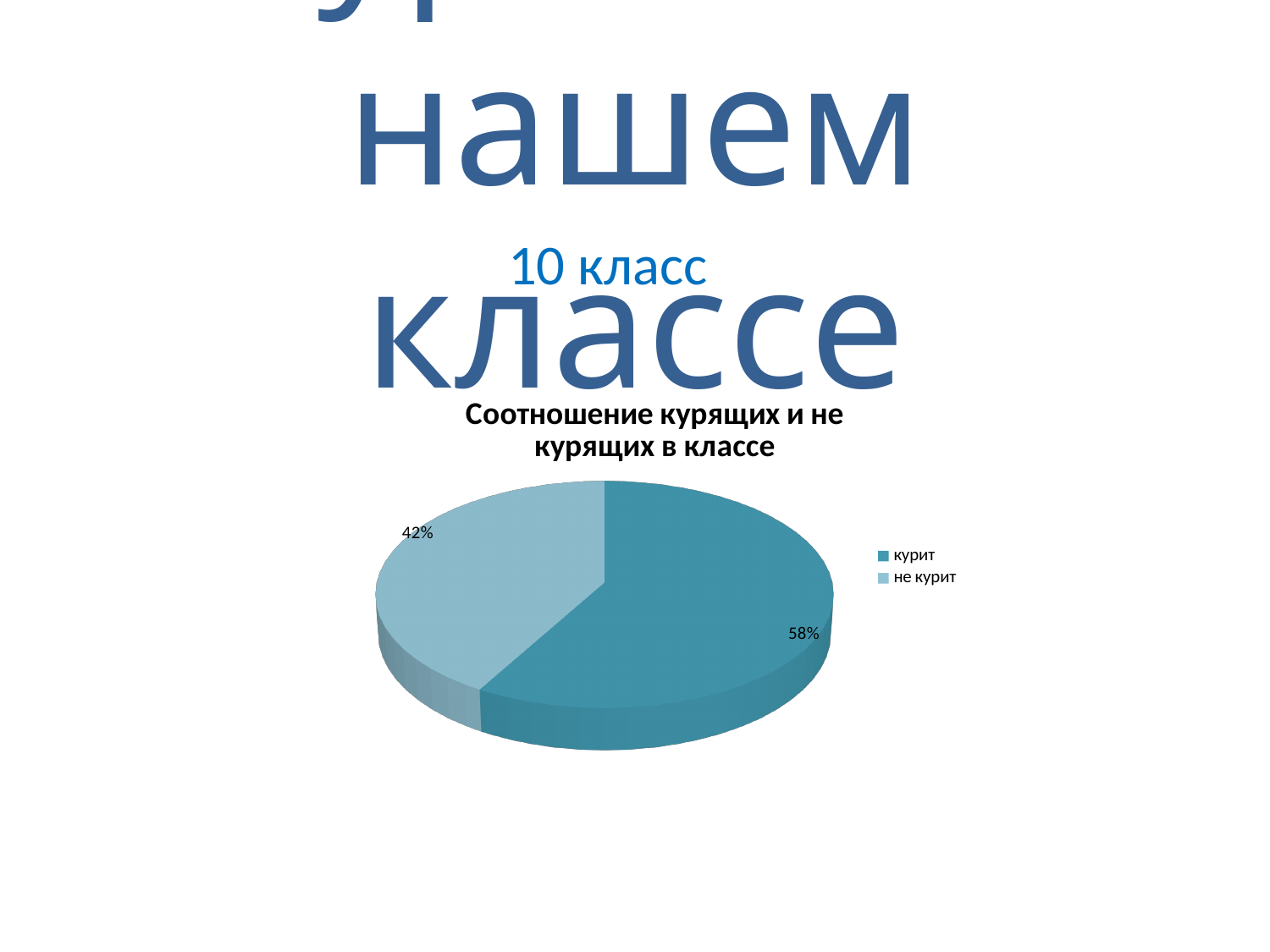
Which is larger, the 'курит' slice or the 'не курит' slice? курит How many entries does the legend list? 2 Which slice is the largest in the pie chart? курит What is the difference between the 'курит' and 'не курит' shares? 16% Which slice is the smallest in the pie chart? не курит Which legend entry is shown in the lighter blue colour? не курит What is the title of the chart? Соотношение курящих и не курящих в классе What kind of chart is shown on the slide? pie chart What share of the pie does the 'курит' slice represent? 58% What share of the pie does the 'не курит' slice represent? 42% How many slices does the pie chart have? 2